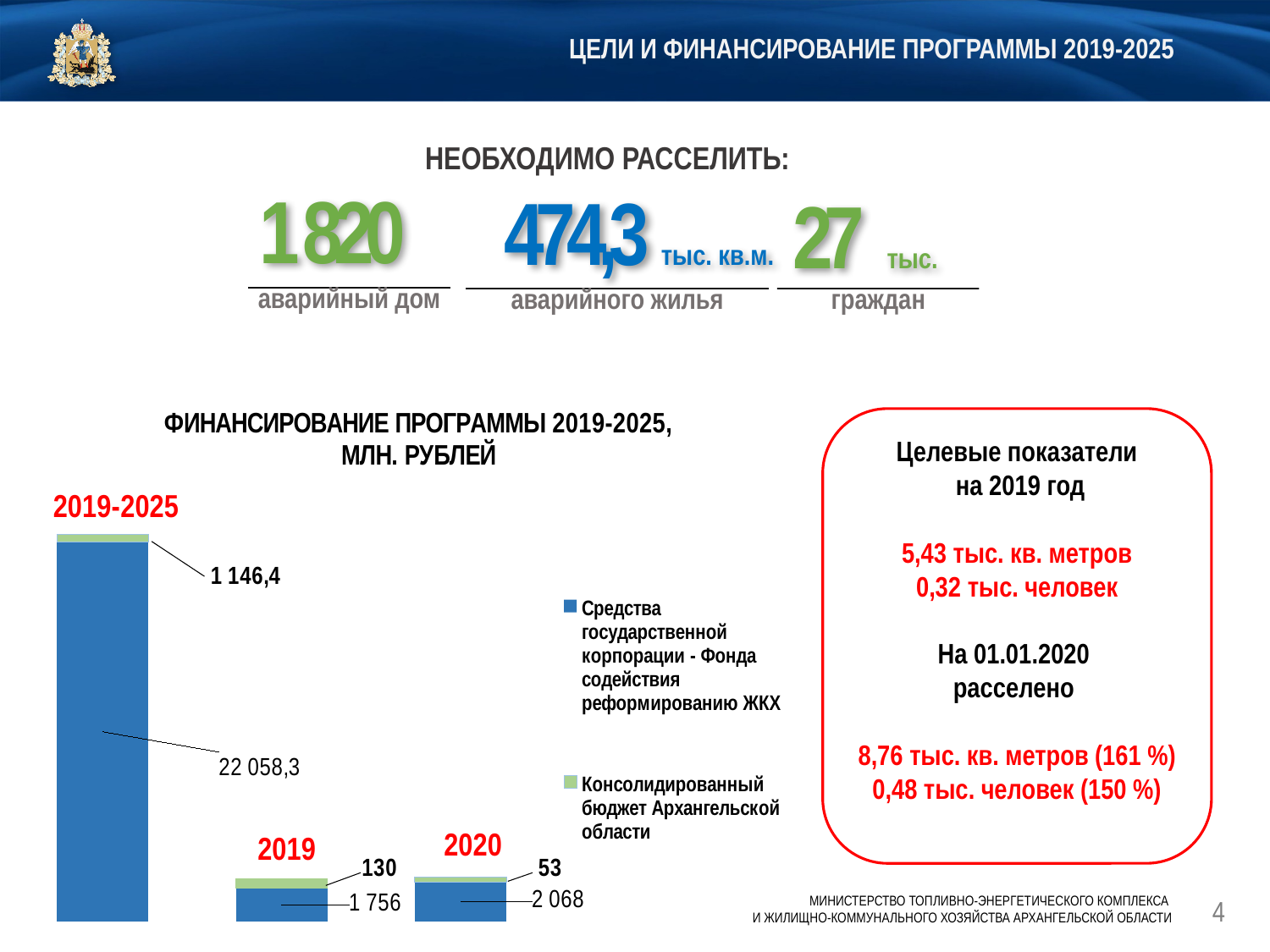
How many series does the legend of the financing chart list? 2 How many categories (bars) are shown in the financing chart? 3 In the financing chart, is the 'Консолидированный бюджет Архангельской области' value larger for 2019 or for 2020? 2019 In the financing chart, which category has the lowest value for 'Консолидированный бюджет Архангельской области'? 2020 In the financing chart, what is the value of 'Средства государственной корпорации - Фонда содействия реформированию ЖКХ' for 2019-2025? 22 058,3 In the financing chart, what is the value of 'Консолидированный бюджет Архангельской области' for 2020? 53 In the financing chart, what is the value of 'Средства государственной корпорации - Фонда содействия реформированию ЖКХ' for 2019? 1 756 In the financing chart, which category has the highest value for 'Средства государственной корпорации - Фонда содействия реформированию ЖКХ'? 2019-2025 In the financing chart, what is the difference between the 'Средства государственной корпорации' values for 2020 and 2019? 312 In the financing chart, what is the total of the stacked bar for 2020? 2 121 In the financing chart, what is the value of 'Консолидированный бюджет Архангельской области' for 2019-2025? 1 146,4 What type of chart is shown under the title 'ФИНАНСИРОВАНИЕ ПРОГРАММЫ 2019-2025, МЛН. РУБЛЕЙ'? Stacked bar chart